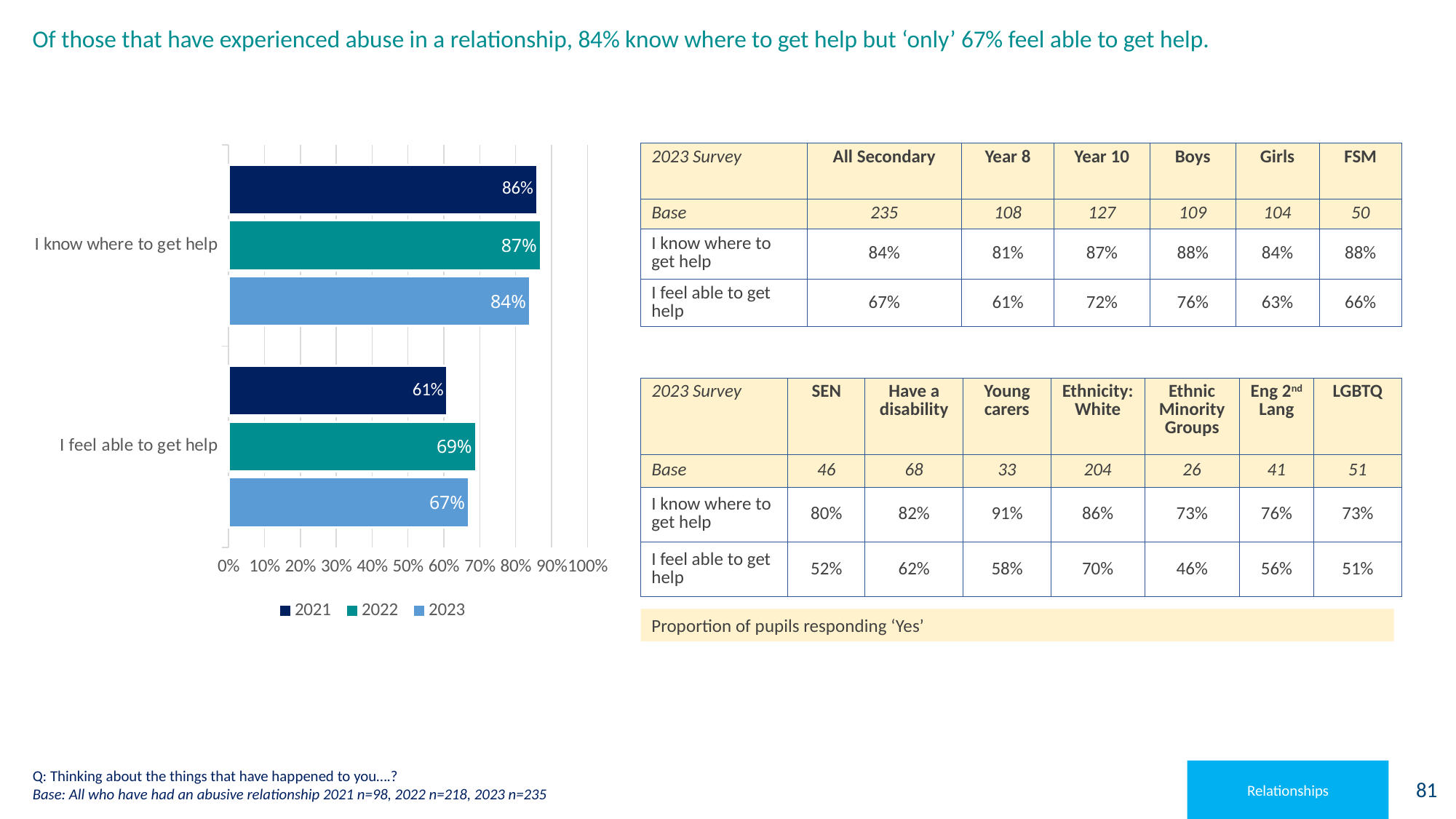
Which is larger: the 2021 value for 'I know where to get help' or the 2022 value for 'I feel able to get help'? 2021 value for 'I know where to get help' Which year has the highest value for 'I feel able to get help'? 2022 How many series does the legend list? 3 Is the 2023 value for 'I feel able to get help' greater or less than 70%? less What kind of chart is shown on the slide? bar chart What is the 2021 value for 'I feel able to get help'? 61% Which series is shown in the darkest colour in the legend? 2021 What is the 2023 value for 'I know where to get help'? 84% What is the 2022 value for 'I know where to get help'? 87% What is the difference between the 2023 values for 'I know where to get help' and 'I feel able to get help'? 17% Which year has the lowest value for 'I know where to get help'? 2023 How many categories are shown on the chart? 2